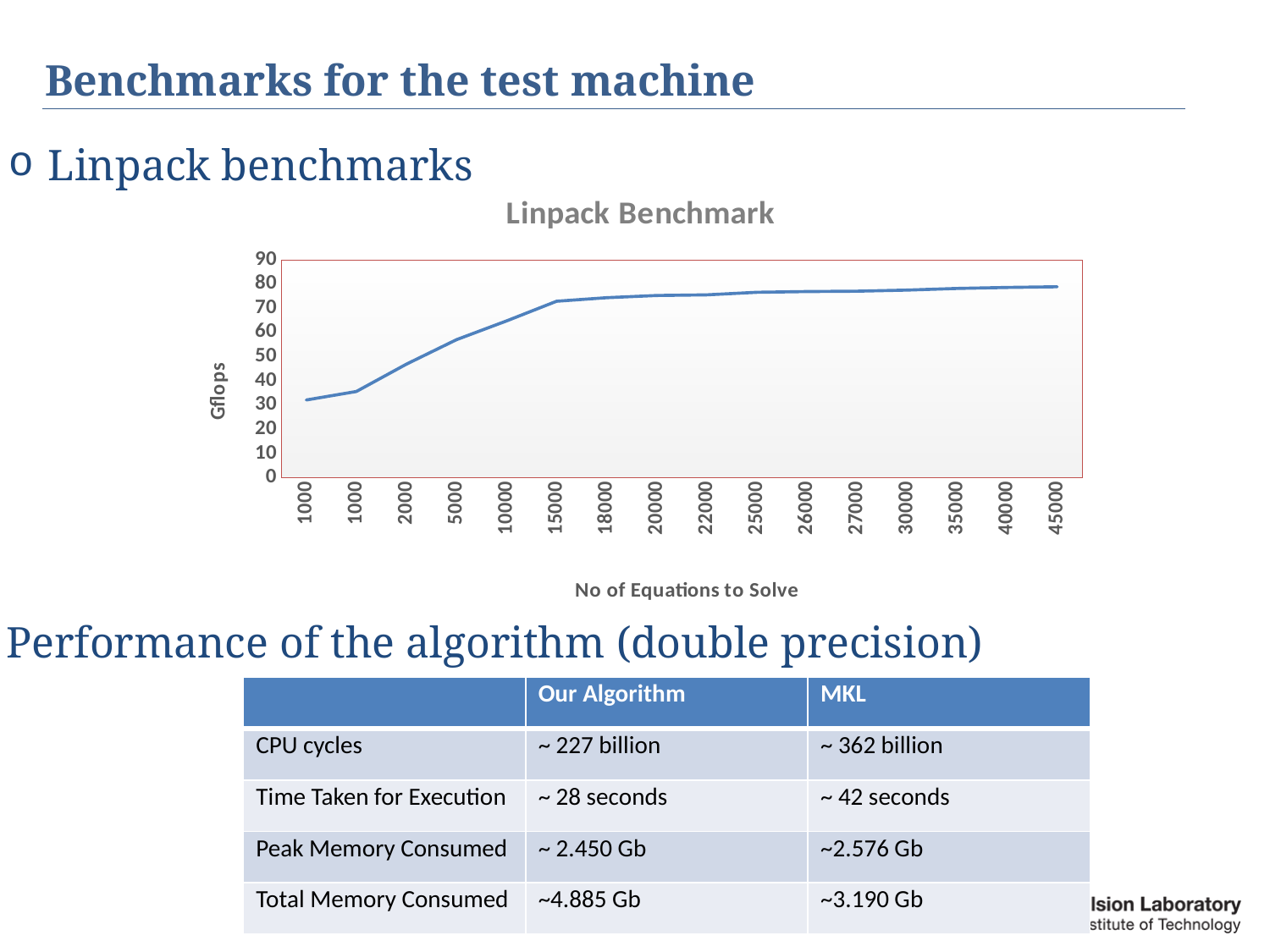
In the Linpack Benchmark chart, is the value for 25000 equations greater or less than 80? less What is the label of the y axis of the Linpack Benchmark chart? Gflops In the Linpack Benchmark chart, is the value for 10000 equations greater or less than 60? greater In the Linpack Benchmark chart, is the value for 5000 equations greater or less than 50? greater In the Linpack Benchmark chart, which number of equations has the lowest Gflops value? 1000 How many data points are plotted along the x axis of the Linpack Benchmark chart? 16 In the Linpack Benchmark chart, which has the higher Gflops value: 5000 equations or 20000 equations? 20000 What kind of chart is the Linpack Benchmark chart? line chart In the Linpack Benchmark chart, do the Gflops values rise or fall as the number of equations increases? rise What is the title of the chart on the slide? Linpack Benchmark